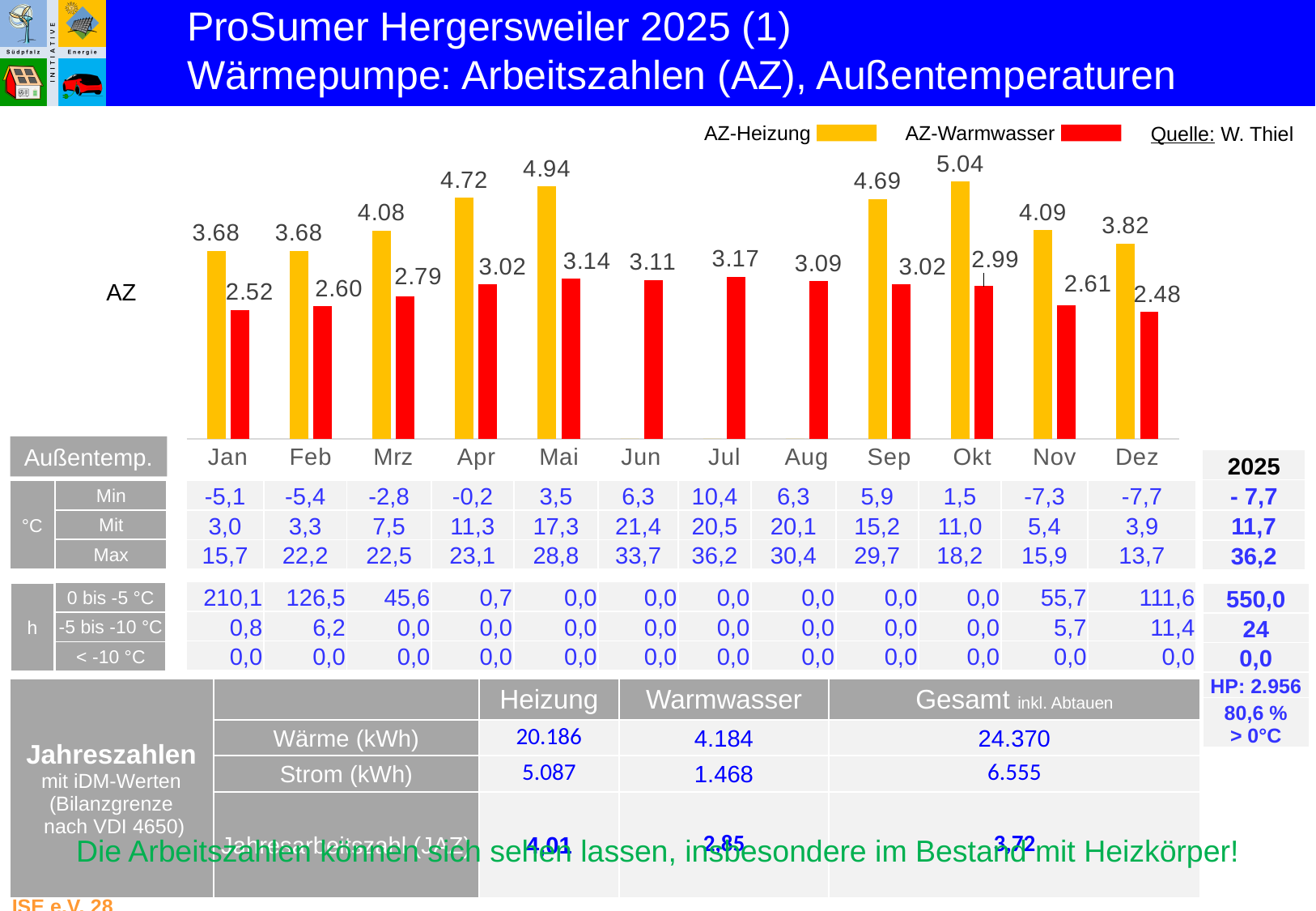
What is the AZ-Warmwasser value for Jan? 2.52 What is the difference between the AZ-Heizung and AZ-Warmwasser values in Okt? 2.05 How many series does the chart legend list? 2 What is the AZ-Heizung value for Okt? 5.04 Which colour represents AZ-Warmwasser in the chart? Red What is the AZ-Heizung value for Mai? 4.94 What kind of chart is used to show the AZ values? Bar chart Which month has the lowest AZ-Warmwasser value? Dez Which is larger, the AZ-Heizung value for Apr or for Sep? Apr Which month has the highest AZ-Warmwasser value? Jul How many months are shown on the x axis of the chart? 12 Which month has the highest AZ-Heizung value? Okt